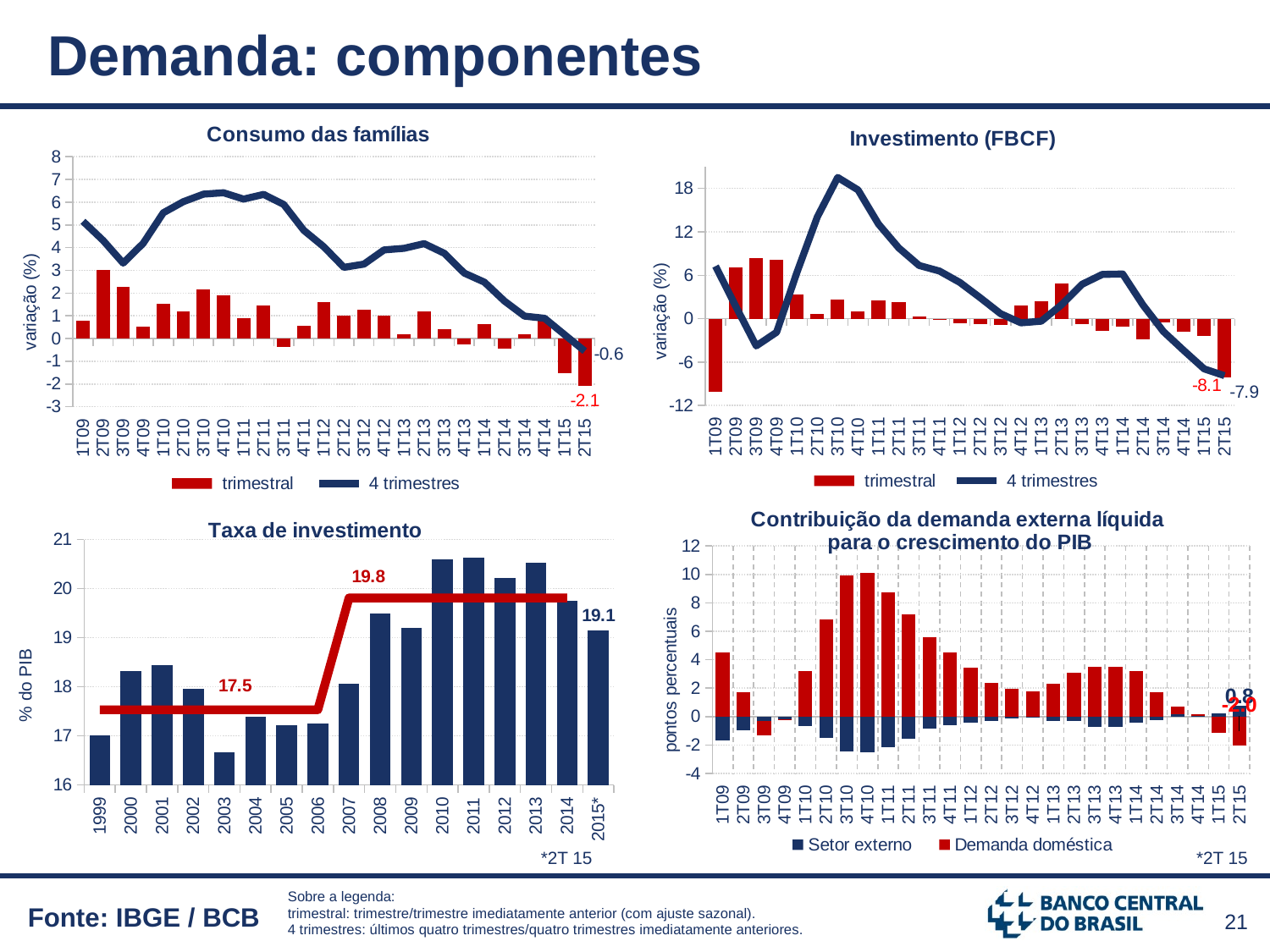
In the 'Consumo das famílias' chart, which quarter has the lowest trimestral value? 2T15 In the 'Investimento (FBCF)' chart, what is the trimestral value for 2T15? -8.1 In the 'Consumo das famílias' chart, is the trimestral value for 2T09 greater or less than 2? greater In the 'Investimento (FBCF)' chart, is the 4 trimestres value for 3T10 greater or less than 12? greater In the 'Consumo das famílias' chart, what is the trimestral value for 2T15? -2.1 In the 'Contribuição da demanda externa líquida para o crescimento do PIB' chart, what is the Demanda doméstica value for 2T15? -2.0 In the 'Investimento (FBCF)' chart, how many series does the legend list? 2 In the 'Investimento (FBCF)' chart, what is the 4 trimestres value for 2T15? -7.9 In the 'Consumo das famílias' chart, what is the 4 trimestres value for 2T15? -0.6 In the 'Taxa de investimento' chart, what is the value for 2015*? 19.1 In the 'Taxa de investimento' chart, which year has the lowest value? 2003 In the 'Taxa de investimento' chart, how many years are shown on the x axis? 17